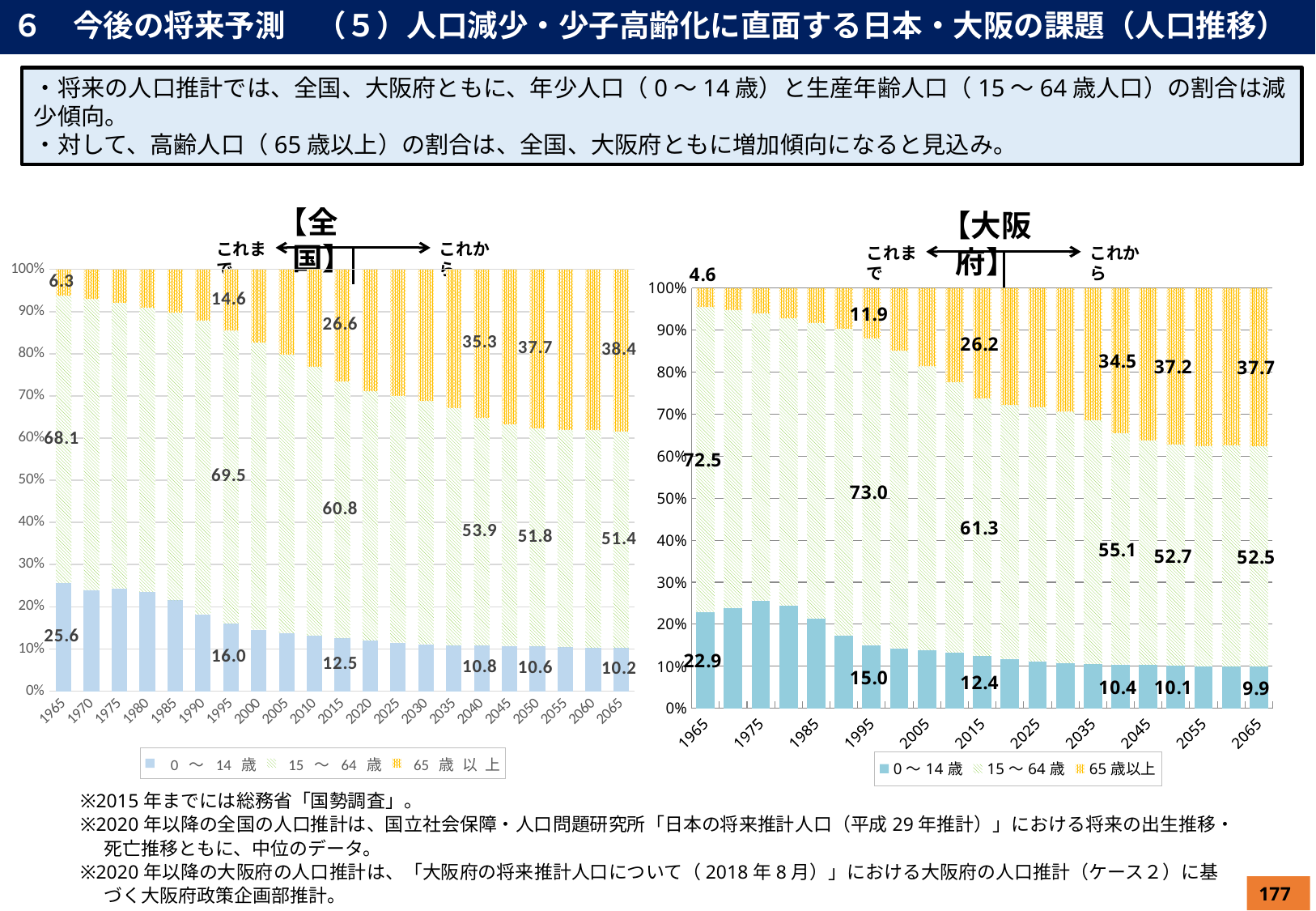
In the 【大阪府】 chart, does the share of 65歳以上 rise or fall from 1965 to 2065? rise In the 【全国】 chart, does the share of 0～14歳 rise or fall from 1965 to 2065? fall In the 【全国】 chart, which year has the lowest labelled value for 0～14歳? 2065 How many series does the legend of the 【大阪府】 chart list? 3 What kind of chart is the 【全国】 chart? stacked bar chart In the 【全国】 chart, what is the difference between the 15～64歳 values for 1995 and 2065? 18.1 In the 【大阪府】 chart, what is the value for 15～64歳 in 1995? 73.0 In the 【大阪府】 chart, which is larger, the 65歳以上 value in 2015 or in 2040? 2040 In the 【大阪府】 chart, what is the value for 65歳以上 in 2065? 37.7 How many year categories are plotted in the 【全国】 chart? 21 In the 【全国】 chart, what is the value for 0～14歳 in 2065? 10.2 In the 【全国】 chart, what is the value for 65歳以上 in 1965? 6.3